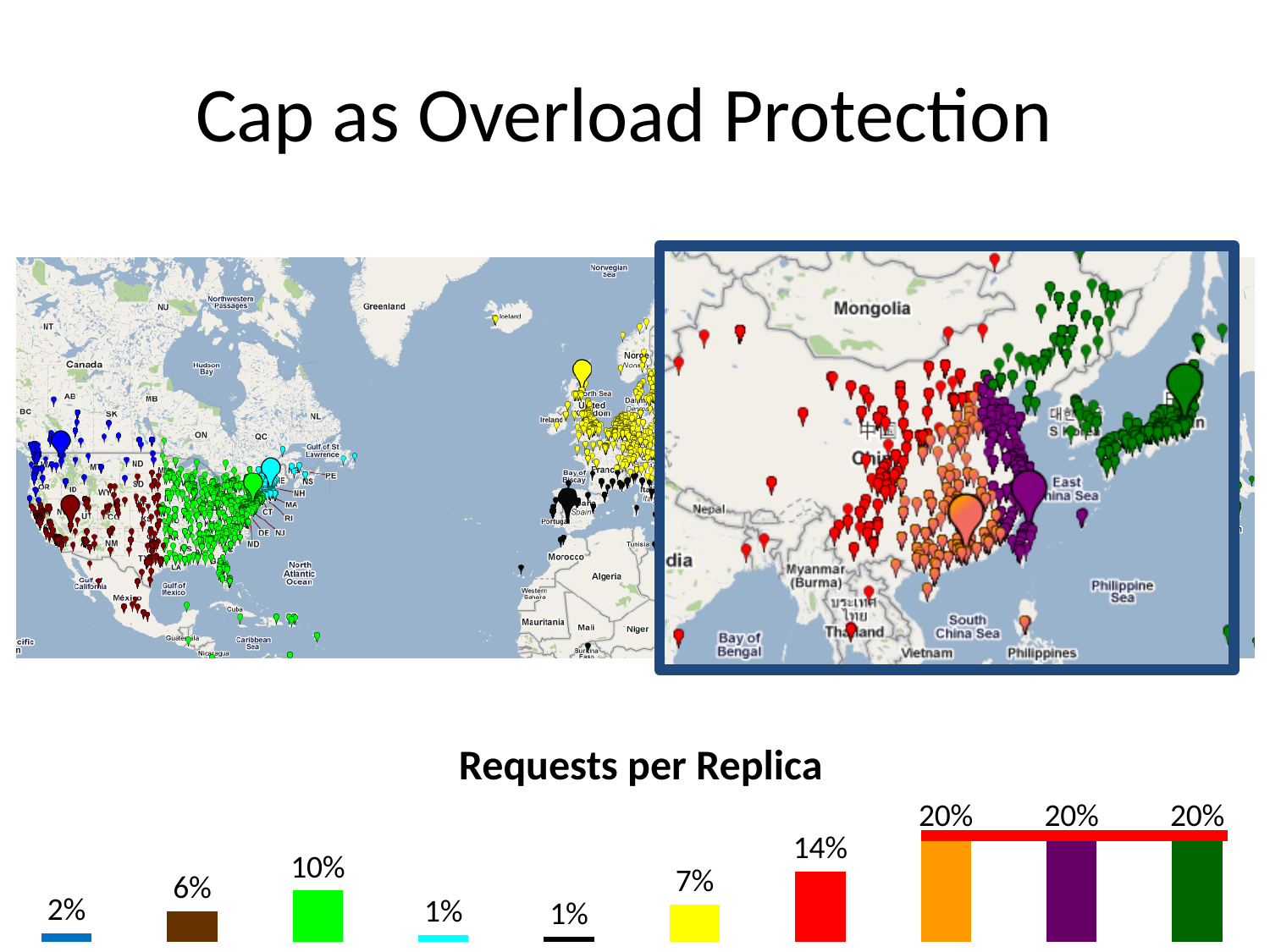
In the "Requests per Replica" chart, what is the lowest value shown on any bar? 1% In the "Requests per Replica" chart, what is the difference between the red bar's value and the yellow bar's value? 7% In the "Requests per Replica" chart, what value is shown for the red bar? 14% In the "Requests per Replica" chart, what value is shown for the brown bar? 6% In the "Requests per Replica" chart, what value is shown for the bright green bar? 10% In the "Requests per Replica" chart, what value is shown for the yellow bar? 7% What kind of chart is shown under the heading "Requests per Replica"? bar chart In the "Requests per Replica" chart, which has the larger value, the bright green bar or the brown bar? the bright green bar What is the title of the bar chart at the bottom of the slide? Requests per Replica How many bars are plotted in the "Requests per Replica" chart? 10 In the "Requests per Replica" chart, what is the highest value shown on any bar? 20% In the "Requests per Replica" chart, what value is shown for the leftmost (blue) bar? 2%